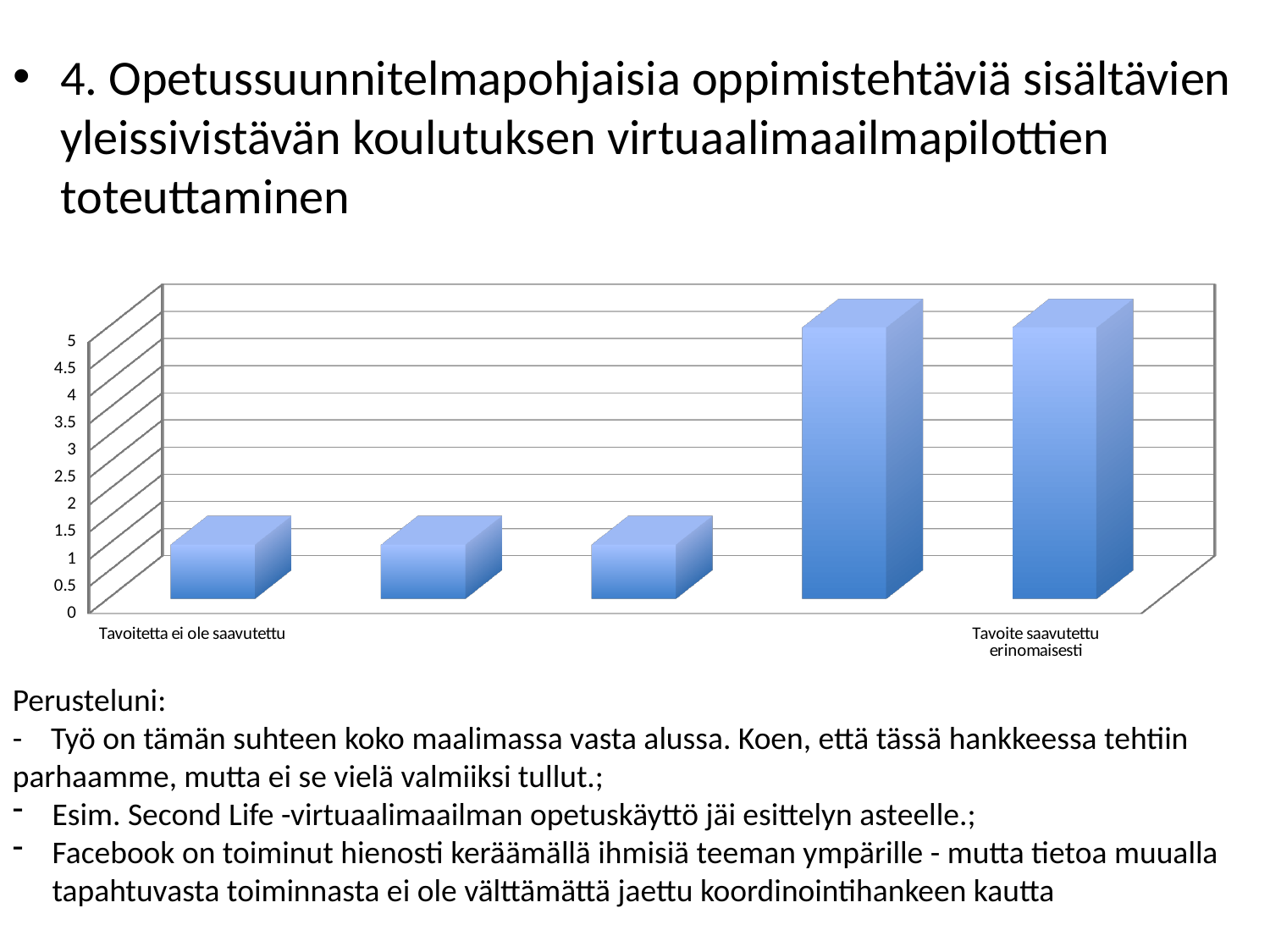
Which is larger, the value for "Tavoitetta ei ole saavutettu" or the value for "Tavoite saavutettu erinomaisesti"? Tavoite saavutettu erinomaisesti Is the value for "Tavoite saavutettu erinomaisesti" greater or less than 3? greater What is the label of the leftmost category on the x axis? Tavoitetta ei ole saavutettu What is the highest value shown on the vertical axis of the chart? 5 Is the value for "Tavoitetta ei ole saavutettu" greater or less than 3? less Is the value for "Tavoitetta ei ole saavutettu" greater or less than 2? less How many bars are plotted in the chart? 5 What kind of chart is shown on the slide? bar chart